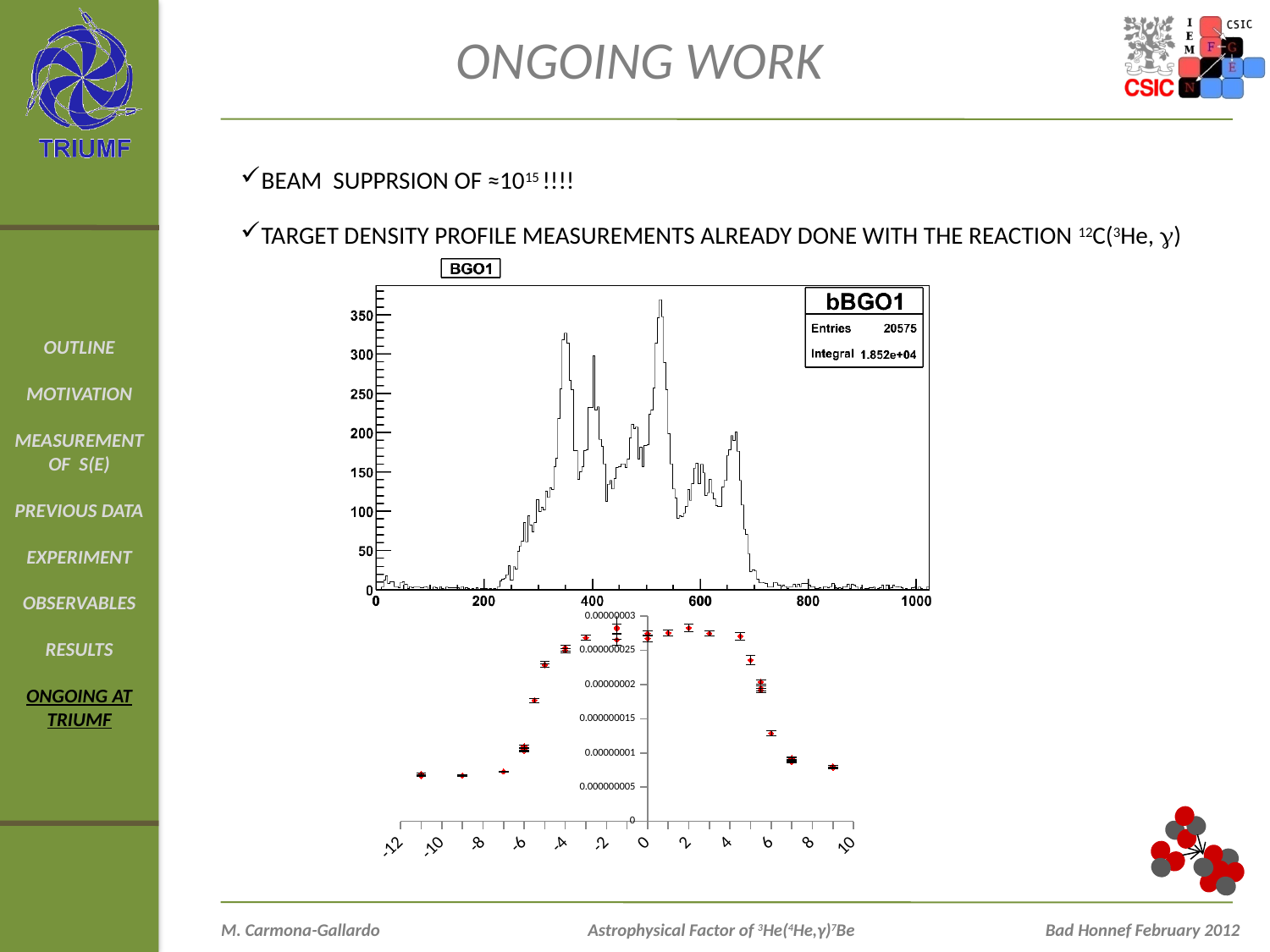
In the top chart BGO1, what is the highest tick label on the y axis? 350 In the top chart BGO1, is the value at x = 800 greater or less than 50? less What kind of chart is the top chart titled BGO1? histogram In the top chart BGO1, what Integral value is shown in the statistics box? 1.852e+04 In the top chart BGO1, is the value of the peak near x = 350 greater or less than 300? greater What kind of chart is the bottom chart on the slide? scatter plot In the bottom chart, is the value at x = 6 greater or less than 0.000000015? less In the top chart BGO1, what is the number of Entries shown in the statistics box? 20575 In the bottom chart, which is larger, the value at x = 2 or the value at x = 9? x = 2 In the bottom chart, do the values rise or fall as x goes from -12 to 0? rise